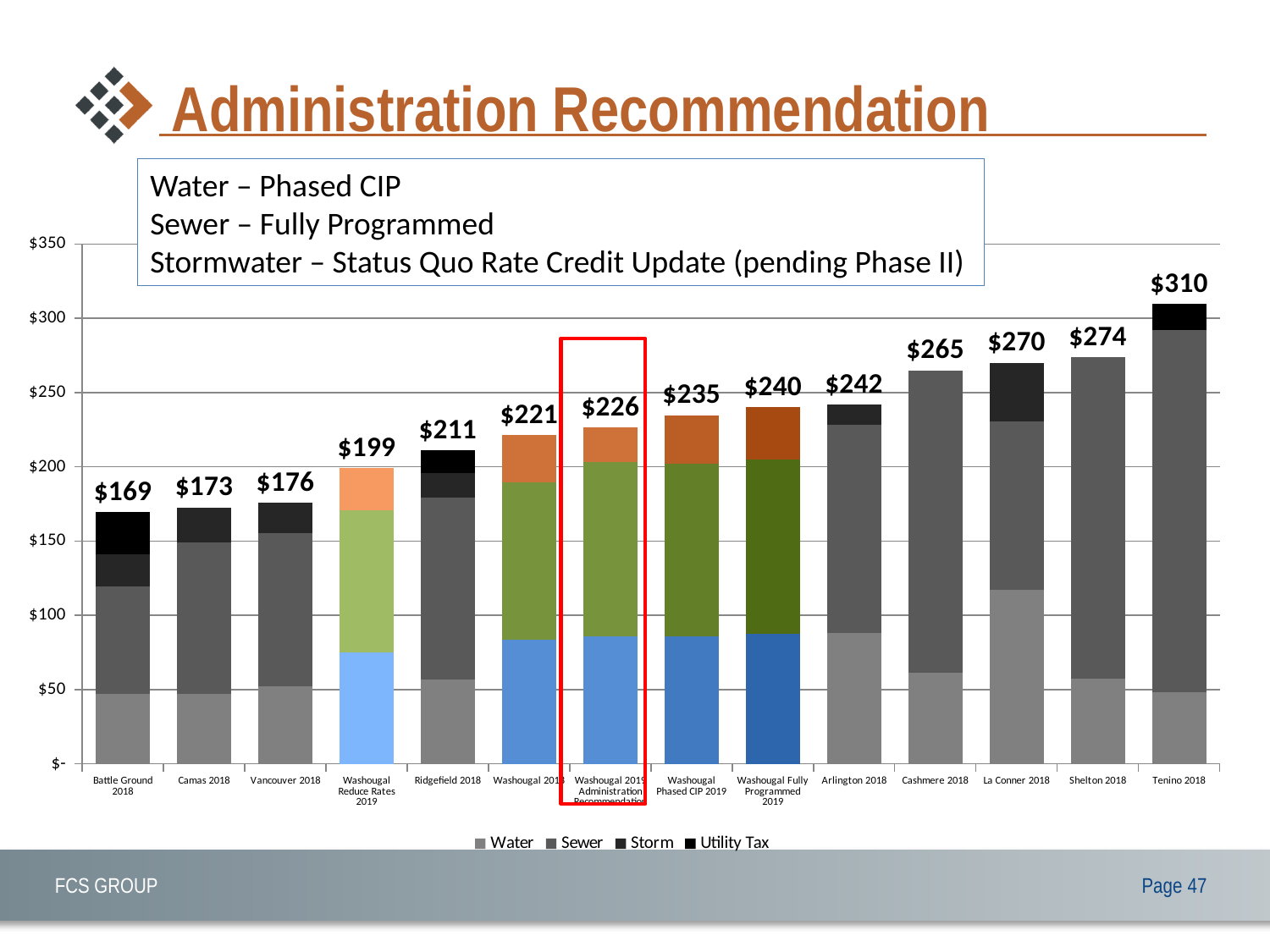
Which category has the lowest total? Battle Ground 2018 How many series does the legend list? 4 Which has a larger total, Washougal Phased CIP 2019 or Washougal Fully Programmed 2019? Washougal Fully Programmed 2019 What is the total labeled on the bar for Tenino 2018? $310 How many categories are shown on the x axis? 14 Which category has the highest total? Tenino 2018 Do the bar totals rise or fall from left to right along the x axis? Rise What kind of chart is shown on the slide? Stacked bar chart Is the Water portion of the Washougal Reduce Rates 2019 bar greater or less than $50? greater What is the difference between the totals for Shelton 2018 and Cashmere 2018? $9 What is the total labeled on the bar for Washougal 2019 Administration Recommendation? $226 What is the total labeled on the bar for Ridgefield 2018? $211